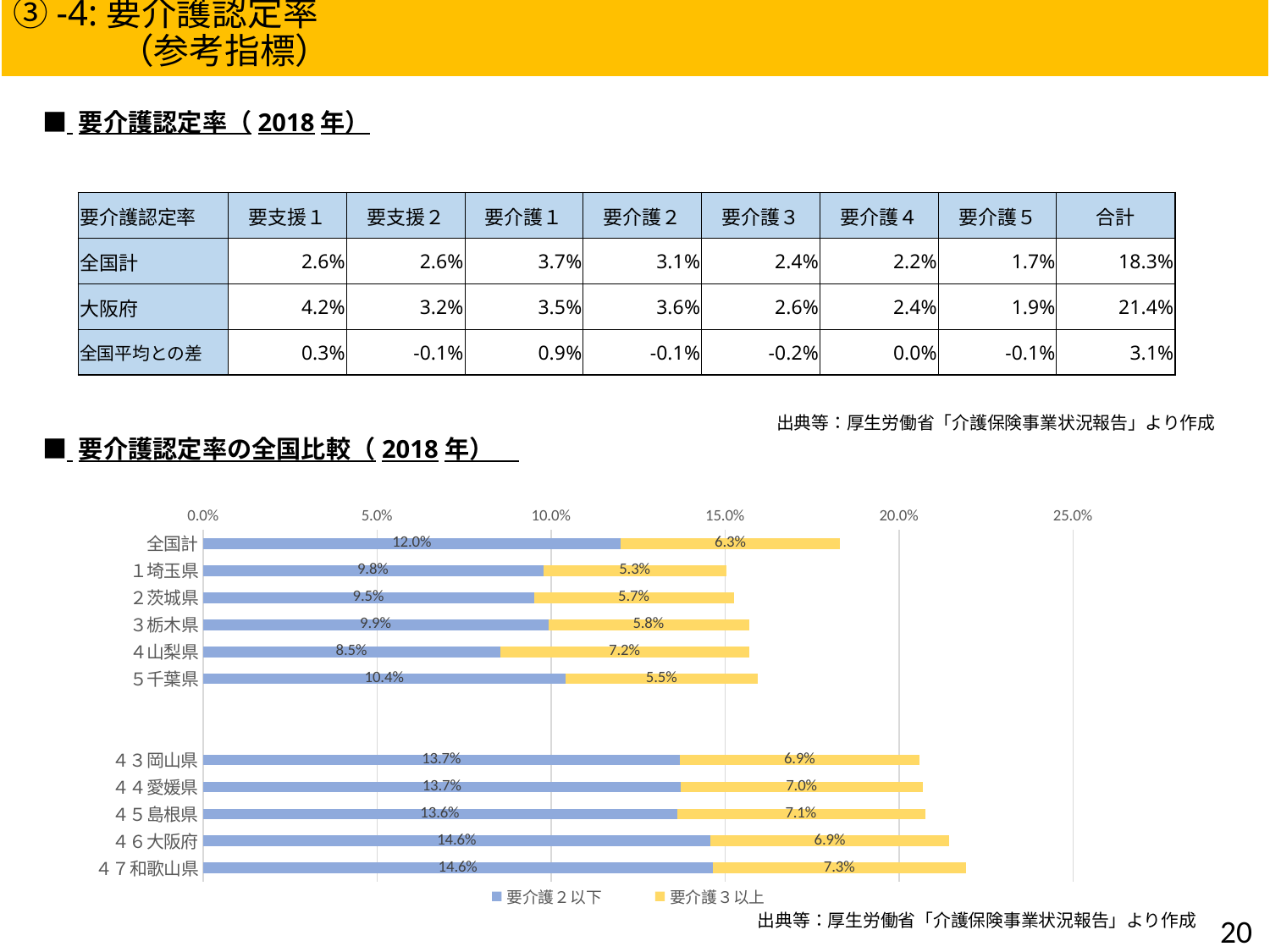
Which has the larger 要介護３以上 value, ４山梨県 or ５千葉県? ４山梨県 What is the difference between the 要介護２以下 and 要介護３以上 values for 全国計? 5.7% Is the total bar length for ４７和歌山県 greater or less than 20.0%? greater What is the total of the stacked bar for 全国計? 18.3% What is the 要介護２以下 value for ４６大阪府? 14.6% Which category has the lowest 要介護２以下 value? ４山梨県 What is the 要介護３以上 value for ４山梨県? 7.2% How many series does the chart legend list? 2 How many categories (rows) are plotted in the chart? 11 Which category has the highest 要介護３以上 value? ４７和歌山県 What kind of chart is shown on the slide? Stacked horizontal bar chart What is the 要介護２以下 value for 全国計? 12.0%